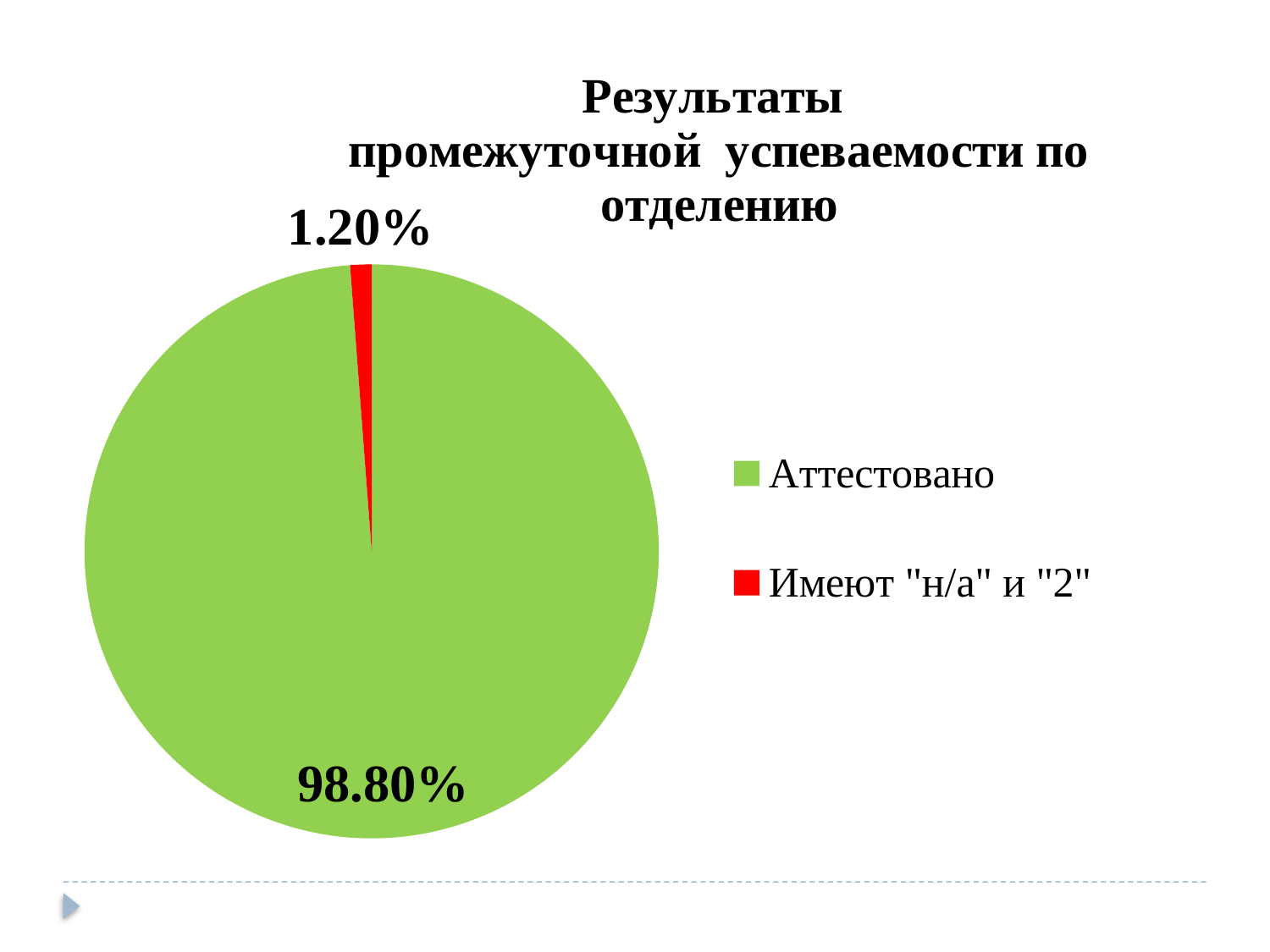
How many entries does the legend list? 2 Which category has the smallest slice of the pie? Имеют "н/а" и "2" What share of the pie does "Имеют "н/а" и "2"" represent? 1.20% Which is larger: the share of "Аттестовано" or the share of "Имеют "н/а" и "2""? Аттестовано What colour is the slice for "Имеют "н/а" и "2""? red What kind of chart is shown on the slide? pie chart What is the difference between the shares of "Аттестовано" and "Имеют "н/а" и "2""? 97.60% How many slices does the pie chart have? 2 Which category has the largest slice of the pie? Аттестовано What is the title of the chart? Результаты промежуточной успеваемости по отделению What share of the pie does "Аттестовано" represent? 98.80%